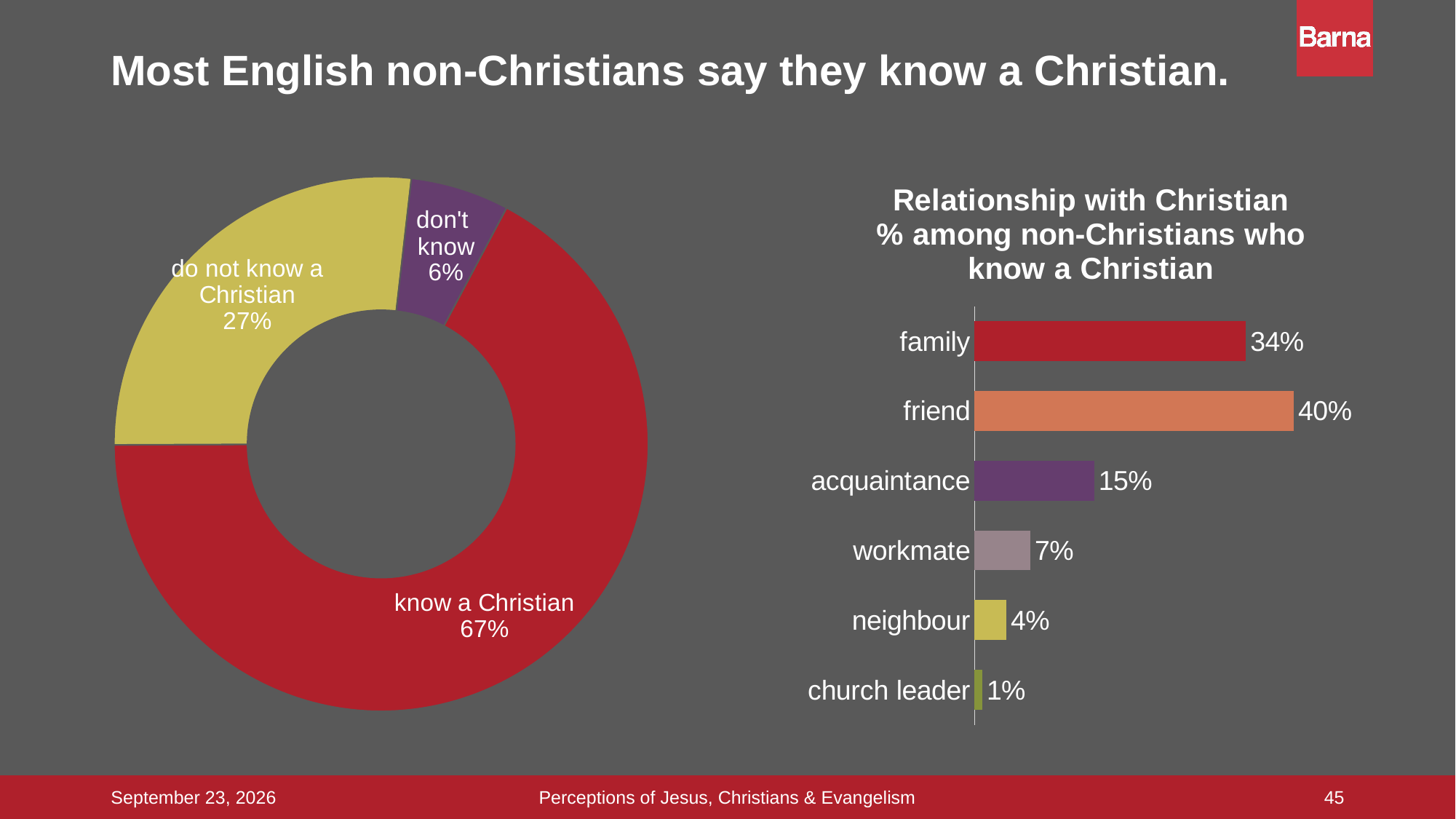
In the doughnut chart on the left, what percentage answered 'don't know'? 6% In the 'Relationship with Christian' chart, which relationship has the highest value? friend In the 'Relationship with Christian' chart, how many relationship categories are shown? 6 In the doughnut chart on the left, what share of English non-Christians say they know a Christian? 67% In the 'Relationship with Christian' chart, which is larger, the value for workmate or the value for neighbour? workmate In the doughnut chart on the left, how many segments are there? 3 In the doughnut chart on the left, what percentage do not know a Christian? 27% In the doughnut chart on the left, which segment is the smallest? don't know In the 'Relationship with Christian' chart, which relationship has the lowest value? church leader In the 'Relationship with Christian' chart, what is the value for acquaintance? 15% In the 'Relationship with Christian' chart, what is the value for friend? 40% In the 'Relationship with Christian' chart, what is the difference between the values for friend and family? 6%